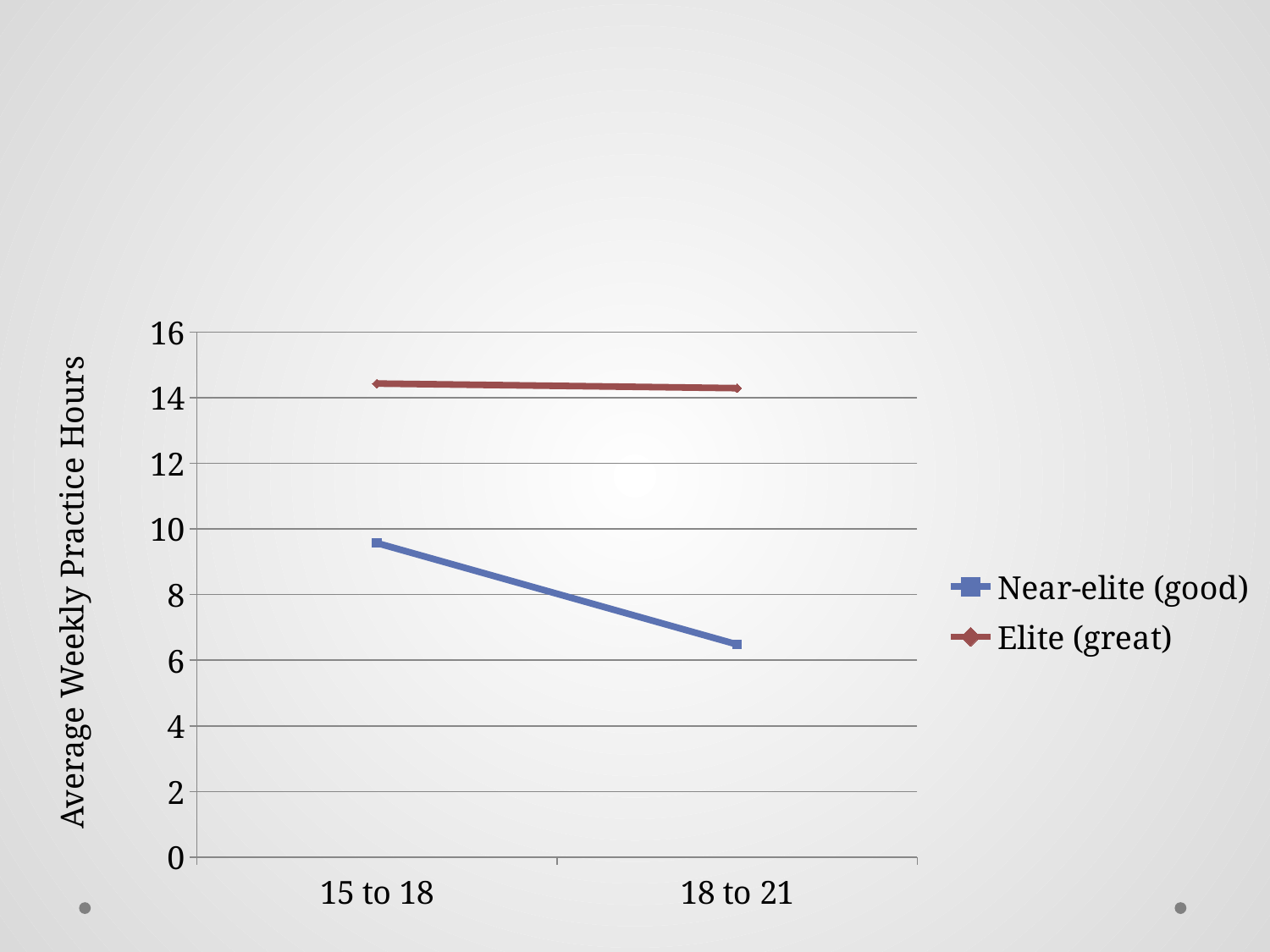
What kind of chart is shown on the slide? line chart Is the value for Near-elite (good) at 18 to 21 greater or less than 8? less Does the Near-elite (good) line rise or fall from 15 to 18 to 18 to 21? fall Which series has the higher value at 15 to 18, Near-elite (good) or Elite (great)? Elite (great) What is the title of the vertical axis? Average Weekly Practice Hours How many age-range categories are shown on the x axis? 2 Is the value for Near-elite (good) at 15 to 18 greater or less than 8? greater Is the value for Elite (great) at 18 to 21 greater or less than 16? less Which series is drawn in blue? Near-elite (good) How many series does the legend list? 2 Which series has the lower value at 18 to 21, Near-elite (good) or Elite (great)? Near-elite (good)